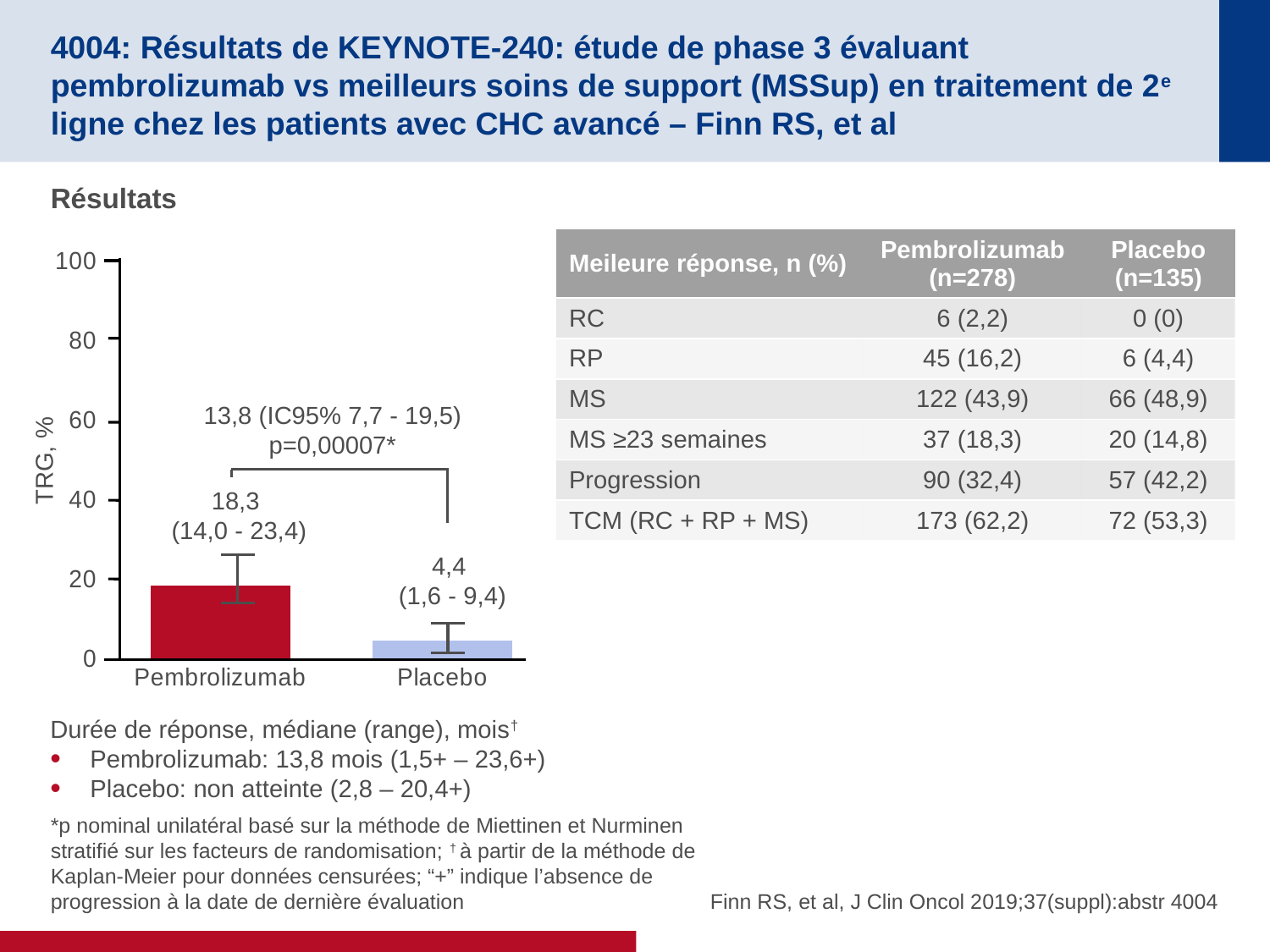
What is the label of the y axis of the bar chart? TRG, % Is the TRG for Placebo greater or less than 20? less What type of chart is shown on the slide? Bar chart How many bars are shown in the chart? 2 Is the TRG for Pembrolizumab greater or less than 20? less What is the TRG value for Pembrolizumab in the bar chart? 18,3 What is the 95% confidence interval shown for the Pembrolizumab bar? 14,0 - 23,4 What is the difference in TRG between Pembrolizumab and Placebo shown on the chart? 13,8 Which group has the higher TRG in the bar chart? Pembrolizumab Which group has the lower TRG in the bar chart? Placebo What p-value is shown on the bar chart for the comparison between Pembrolizumab and Placebo? p=0,00007* What is the TRG value for Placebo in the bar chart? 4,4